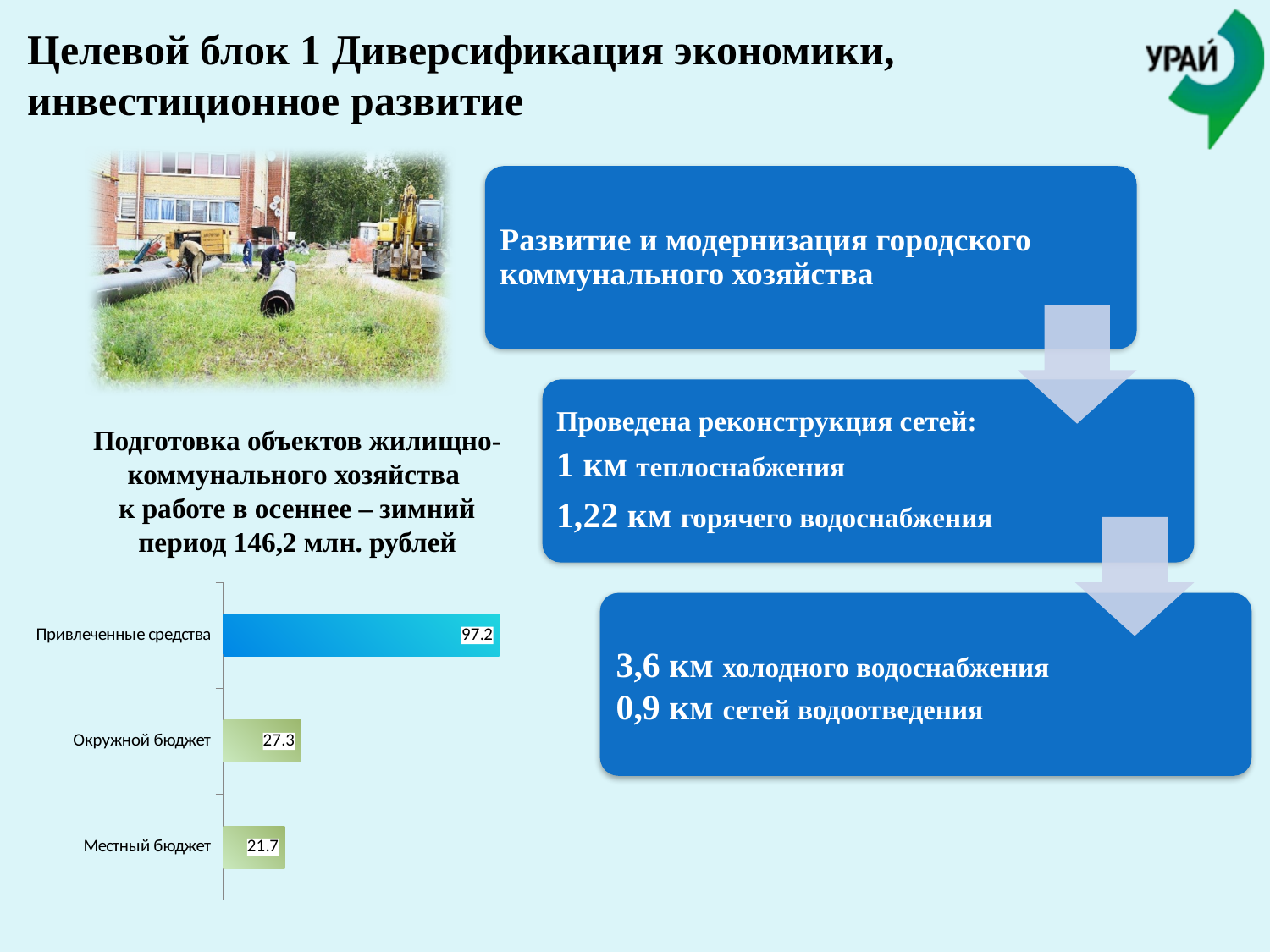
Which bar in the chart is coloured blue? Привлеченные средства Which is larger, the value for Окружной бюджет or the value for Местный бюджет? Окружной бюджет Which category has the lowest value? Местный бюджет What is the difference between the values for Окружной бюджет and Местный бюджет? 5.6 How many categories are shown in the chart? 3 What is the difference between the values for Привлеченные средства and Окружной бюджет? 69.9 Which category has the highest value? Привлеченные средства What kind of chart is shown on the slide? bar chart What is the value for Привлеченные средства? 97.2 What is the value for Местный бюджет? 21.7 What is the value for Окружной бюджет? 27.3 What is the sum of the three values shown in the chart? 146.2